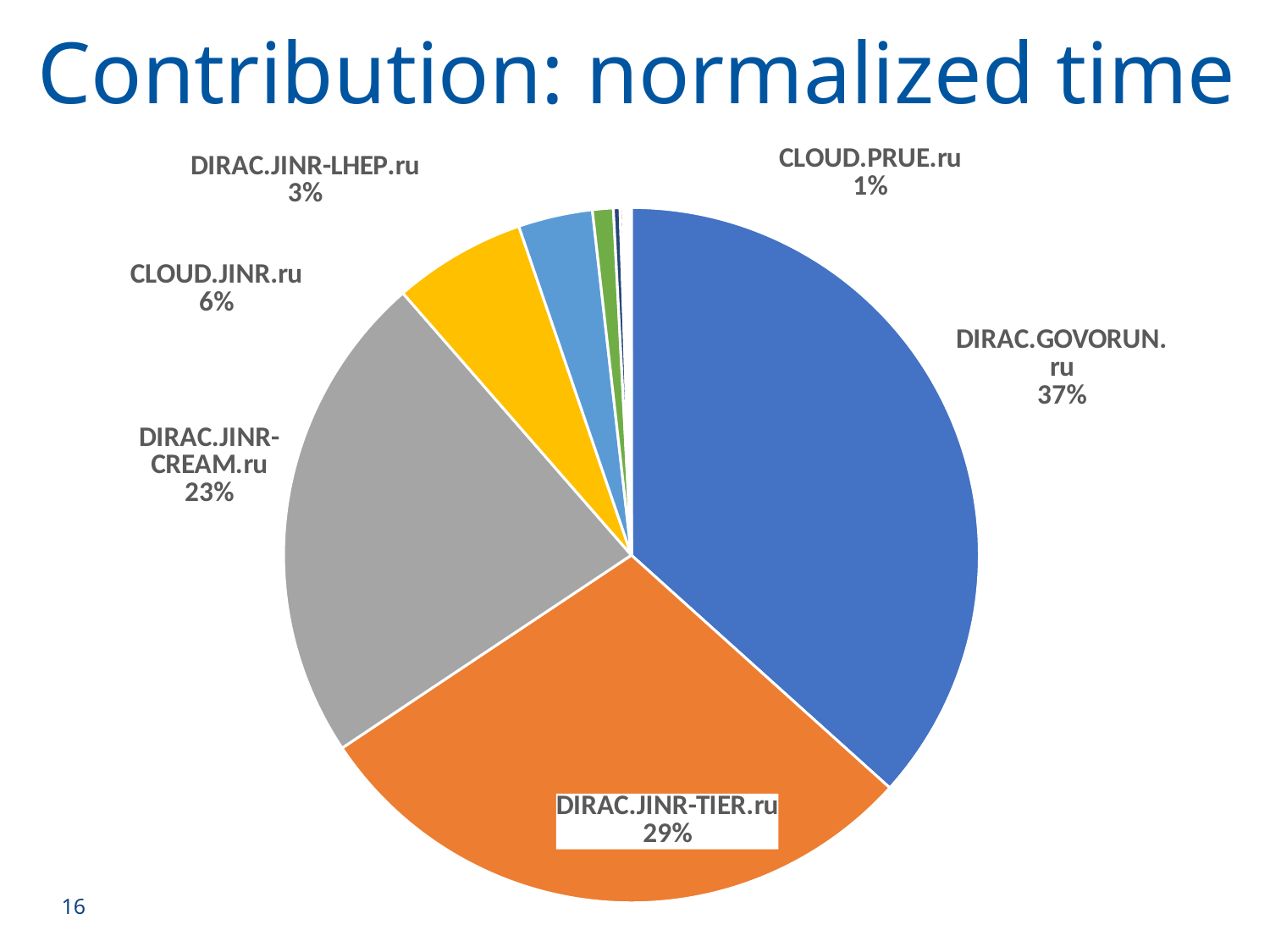
What percentage is shown for DIRAC.JINR-TIER.ru? 29% What kind of chart is shown on the slide? Pie chart What percentage is shown for DIRAC.JINR-LHEP.ru? 3% What share of the pie does DIRAC.GOVORUN.ru have? 37% What is the difference in percentage points between DIRAC.GOVORUN.ru and DIRAC.JINR-TIER.ru? 8 What percentage is shown for DIRAC.JINR-CREAM.ru? 23% What is the title of the slide containing the chart? Contribution: normalized time Which site has the largest share of the pie? DIRAC.GOVORUN.ru Which labeled site has the smallest share of the pie? CLOUD.PRUE.ru What share of the pie does CLOUD.JINR.ru have? 6% Which has a larger share, DIRAC.JINR-CREAM.ru or CLOUD.JINR.ru? DIRAC.JINR-CREAM.ru What percentage is shown for CLOUD.PRUE.ru? 1%